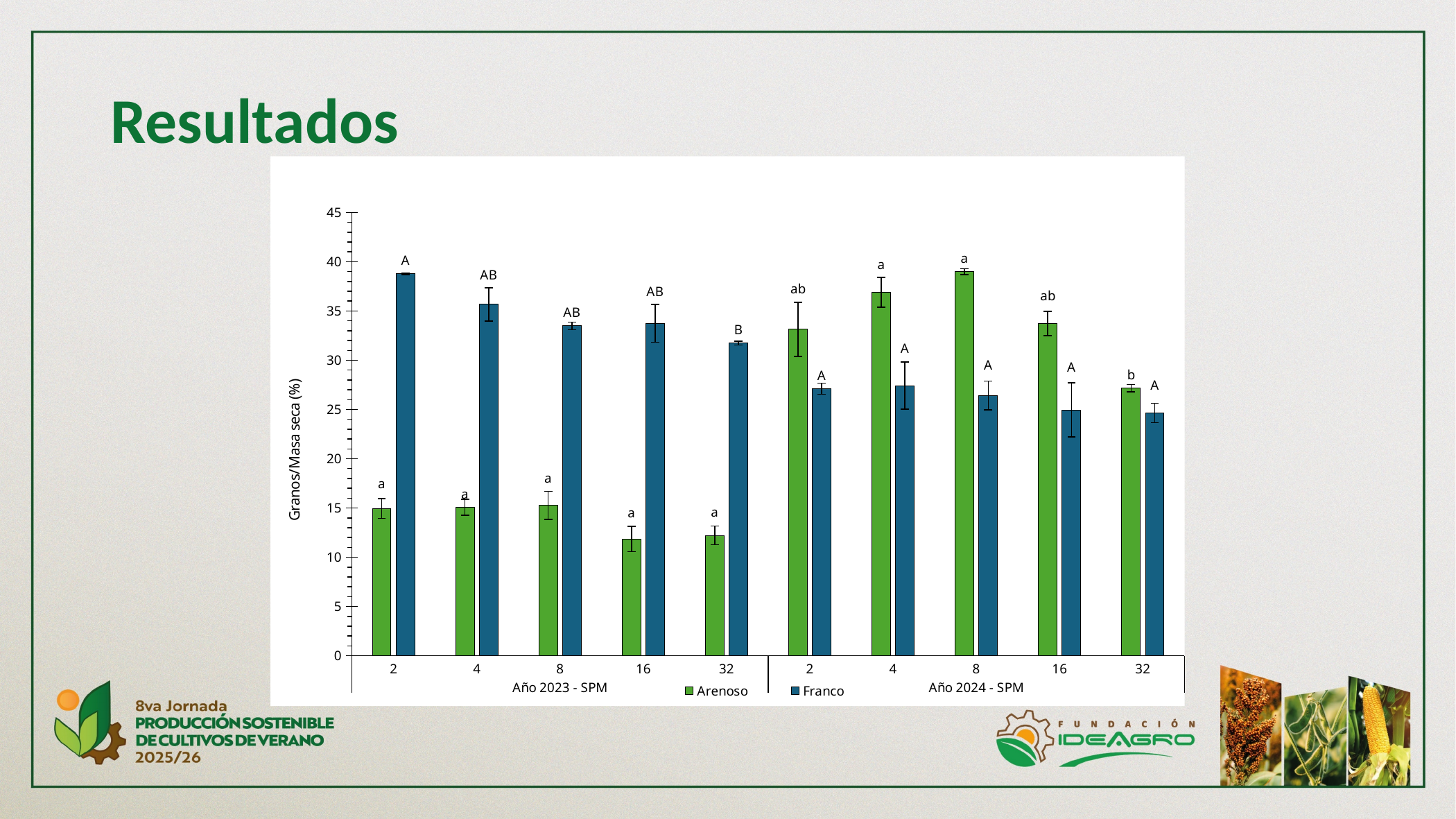
In Año 2023, at which SPM level is the Franco bar highest? 2 Is the Arenoso value at SPM level 32 in Año 2024 greater or less than 25? greater What are the two series named in the chart legend? Arenoso and Franco What is the title of the vertical axis of the chart? Granos/Masa seca (%) Is the Arenoso value at SPM level 16 in Año 2023 greater or less than 15? less What kind of chart is shown on the slide? Bar chart How many series does the chart legend list? 2 In Año 2024, at which SPM level is the Arenoso bar highest? 8 How many SPM levels are shown on the x axis for each year? 5 At SPM level 2 in Año 2023, which series has the larger value, Arenoso or Franco? Franco At SPM level 8 in Año 2024, which series has the larger value, Arenoso or Franco? Arenoso Is the Franco value at SPM level 2 in Año 2023 greater or less than 35? greater